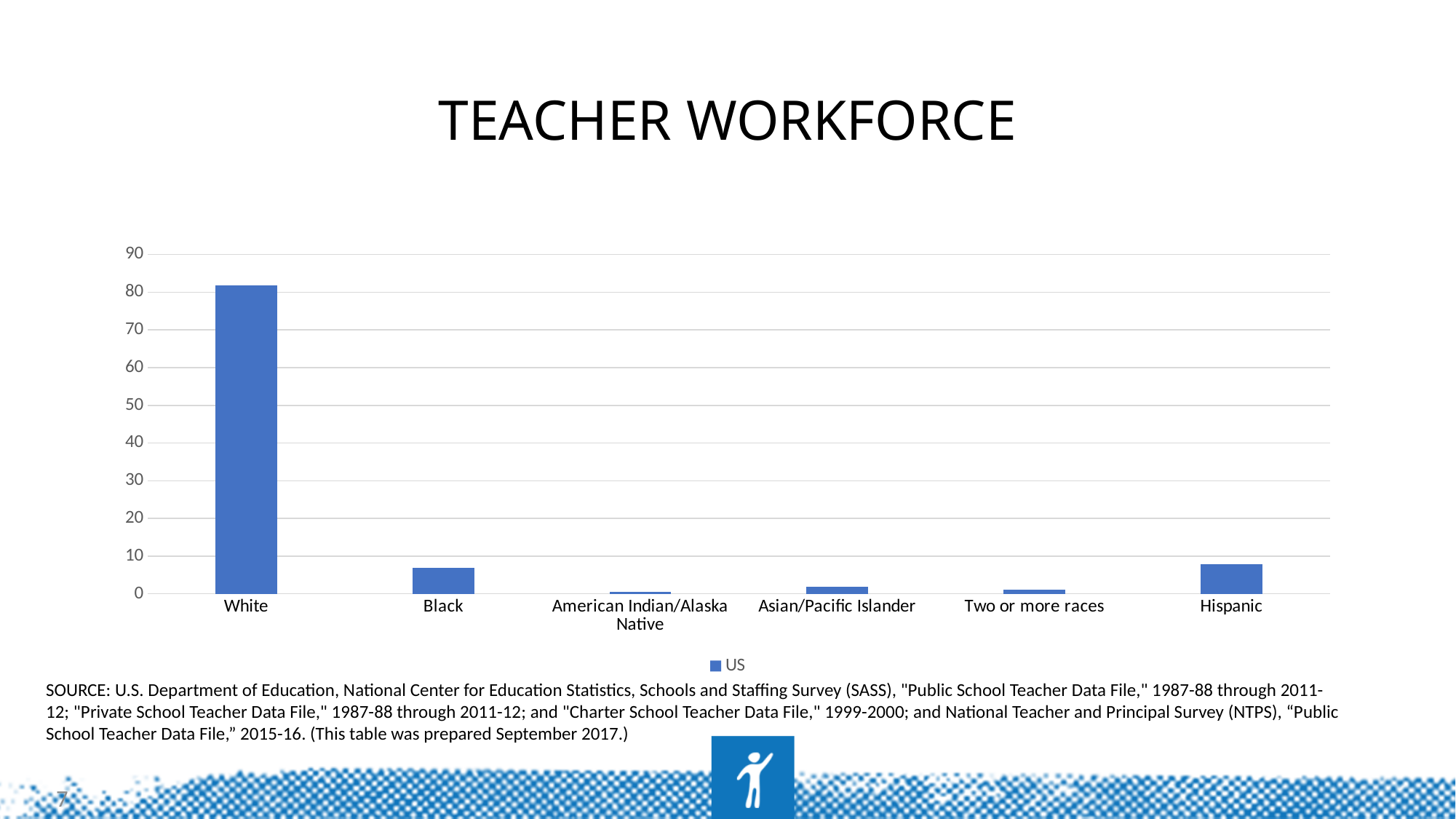
What is the title of the slide containing the chart? TEACHER WORKFORCE What kind of chart is shown on the slide? bar chart Which category has the highest value in the chart? White How many series does the chart's legend list? 1 What series name is shown in the chart's legend? US Which is larger, the value for White or the value for Black? White Is the value for Asian/Pacific Islander greater or less than 10? less Is the value for Hispanic greater or less than 10? less Which is larger, the value for Asian/Pacific Islander or the value for Two or more races? Asian/Pacific Islander Is the value for Black greater or less than 10? less How many categories are shown on the x axis of the chart? 6